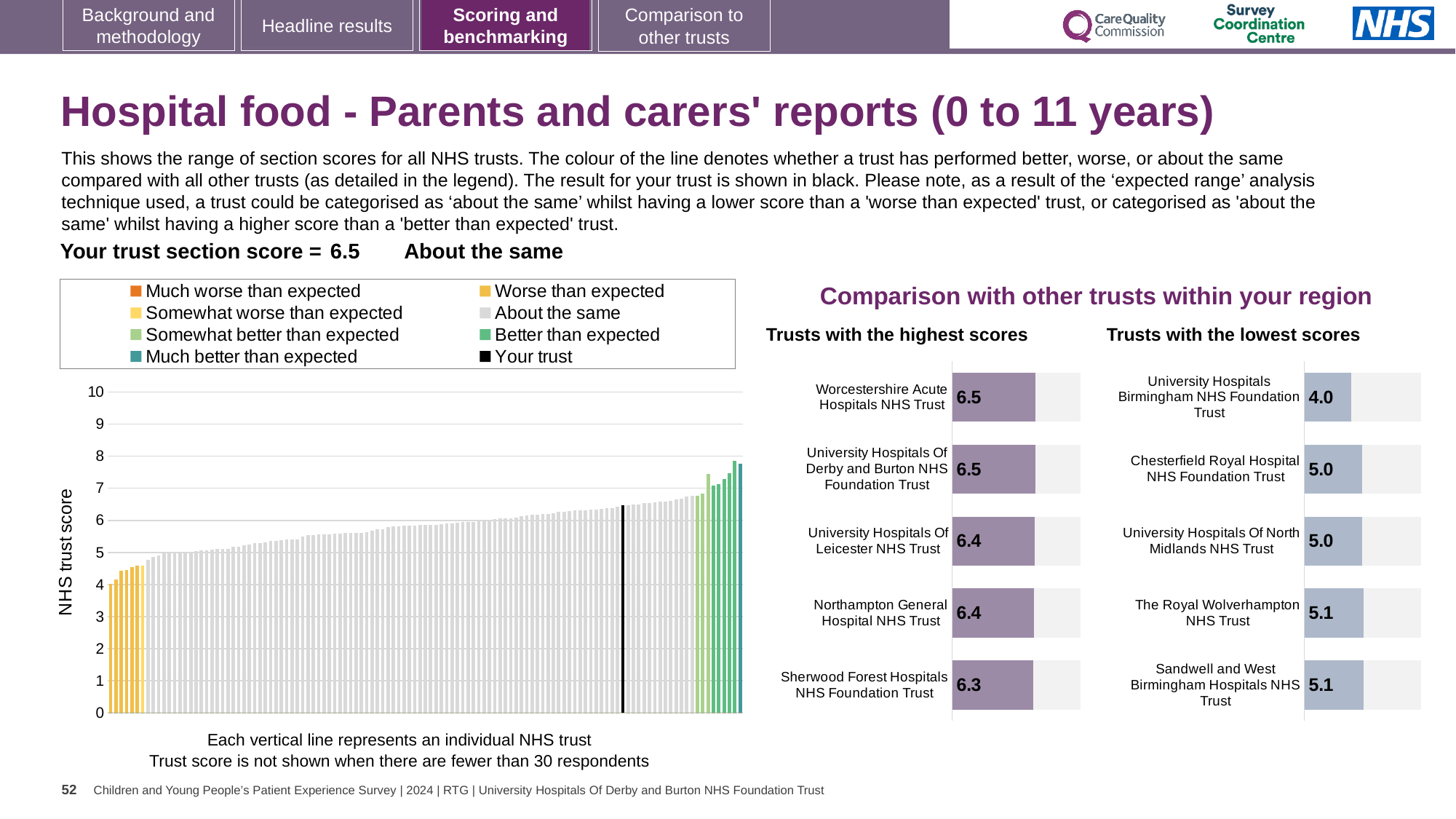
How many entries does the legend of the main chart on the left list? 8 In the 'Trusts with the lowest scores' chart, what is the difference between the scores of Sandwell and West Birmingham Hospitals NHS Trust and University Hospitals Birmingham NHS Foundation Trust? 1.1 In the main chart on the left, do the bar values rise or fall from left to right? rise How many trusts are listed in the 'Trusts with the highest scores' chart? 5 In the 'Trusts with the lowest scores' chart, what is the score for University Hospitals Birmingham NHS Foundation Trust? 4.0 In the main chart on the left, is the value of the tallest bar greater or less than 7? greater In the 'Trusts with the highest scores' chart, what is the difference between the scores of Worcestershire Acute Hospitals NHS Trust and Sherwood Forest Hospitals NHS Foundation Trust? 0.2 In the 'Trusts with the lowest scores' chart, which trust has the lowest score? University Hospitals Birmingham NHS Foundation Trust In the 'Trusts with the highest scores' chart, what is the score for Northampton General Hospital NHS Trust? 6.4 In the 'Trusts with the highest scores' chart, which trust has the lowest score? Sherwood Forest Hospitals NHS Foundation Trust What kind of chart is the main chart on the left of the slide? bar chart In the 'Trusts with the lowest scores' chart, which has the higher score: Chesterfield Royal Hospital NHS Foundation Trust or The Royal Wolverhampton NHS Trust? The Royal Wolverhampton NHS Trust